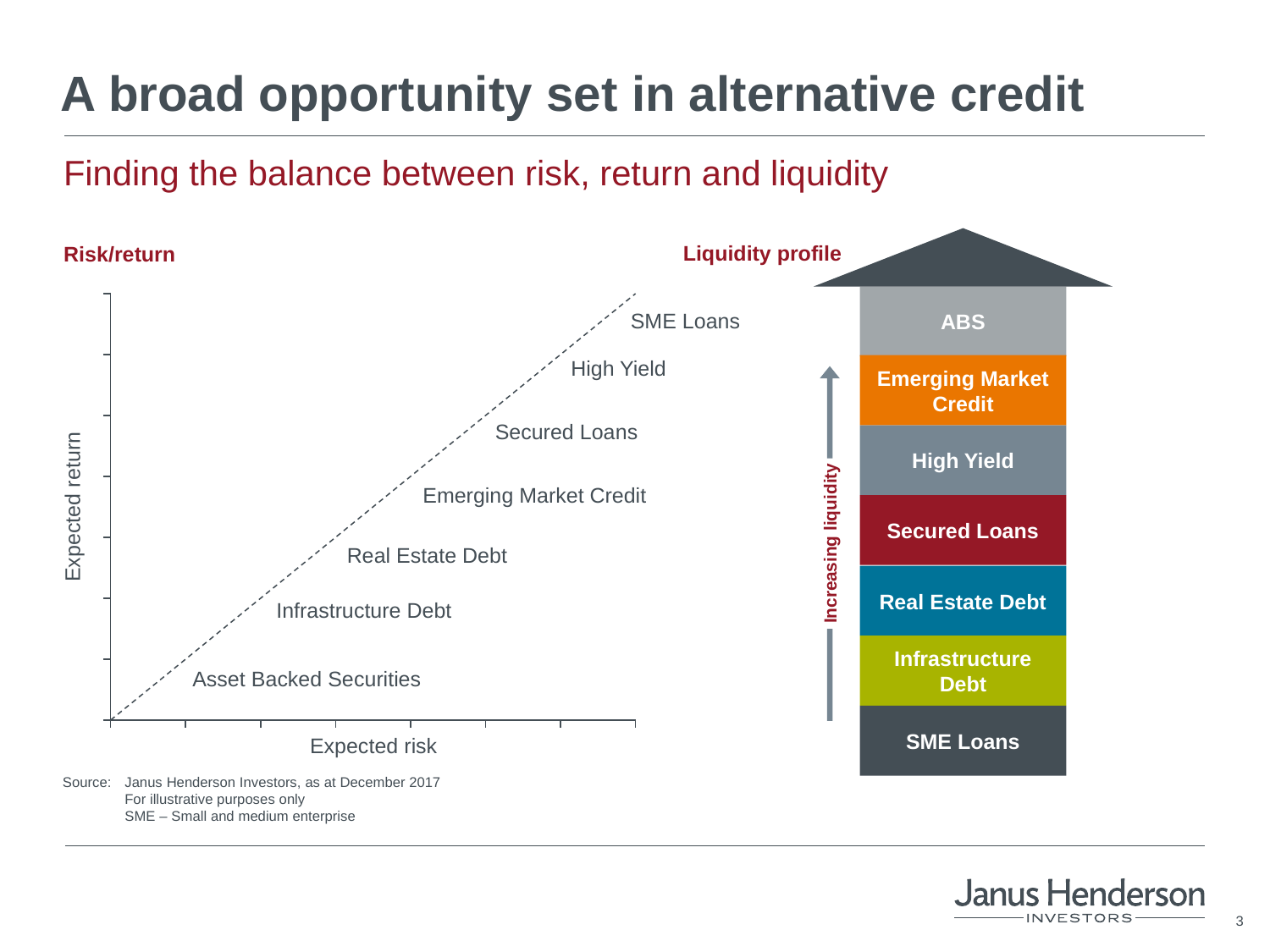
In the Liquidity profile diagram, which asset class is shown as the most liquid (at the top)? ABS What is the label on the x axis of the Risk/return chart? Expected risk On the Risk/return chart, which has the lower expected risk: Infrastructure Debt or Real Estate Debt? Infrastructure Debt How many asset classes are listed in the Liquidity profile diagram? 7 On the Risk/return chart, how many asset classes are plotted along the dashed line? 7 In the Liquidity profile diagram, which asset class is shown as the least liquid (at the bottom)? SME Loans On the Risk/return chart, which asset class has the lowest expected risk? Asset Backed Securities On the Risk/return chart, which asset class has the highest expected return? SME Loans On the Risk/return chart, which asset class sits immediately above Emerging Market Credit on the dashed line? Secured Loans On the Risk/return chart, which has the higher expected return: High Yield or Secured Loans? High Yield What is the label on the y axis of the Risk/return chart? Expected return On the Risk/return chart, does expected return rise or fall as expected risk increases along the x axis? rise